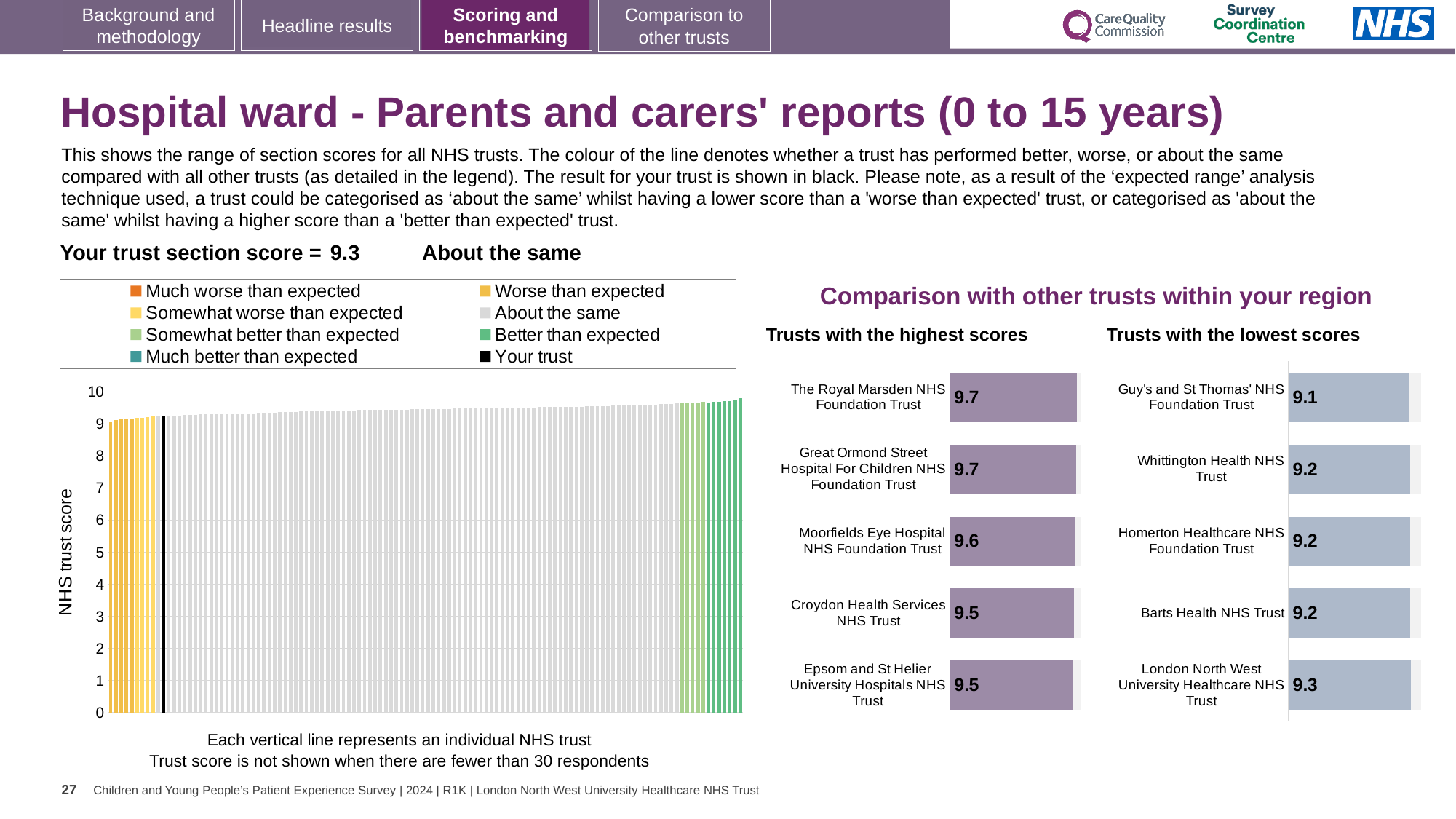
In the 'Trusts with the highest scores' chart, what is the score for Moorfields Eye Hospital NHS Foundation Trust? 9.6 How many trusts are shown in the 'Trusts with the lowest scores' chart? 5 How many entries does the legend of the main chart on the left list? 8 In the main chart on the left, is the value for the leftmost yellow bar greater or less than 8? greater What is the section score for your trust shown in black on the main chart? 9.3 What is the difference between The Royal Marsden NHS Foundation Trust's score in the 'highest scores' chart and Guy's and St Thomas' NHS Foundation Trust's score in the 'lowest scores' chart? 0.6 In the 'Trusts with the lowest scores' chart, which trust has the highest score? London North West University Healthcare NHS Trust In the 'Trusts with the lowest scores' chart, what is the score for Whittington Health NHS Trust? 9.2 In the 'Trusts with the lowest scores' chart, which trust has the lowest score? Guy's and St Thomas' NHS Foundation Trust In the 'Trusts with the highest scores' chart, which has the larger score: Moorfields Eye Hospital NHS Foundation Trust or Croydon Health Services NHS Trust? Moorfields Eye Hospital NHS Foundation Trust What is the y-axis label of the main chart on the left? NHS trust score In the 'Trusts with the highest scores' chart, what is the score for The Royal Marsden NHS Foundation Trust? 9.7